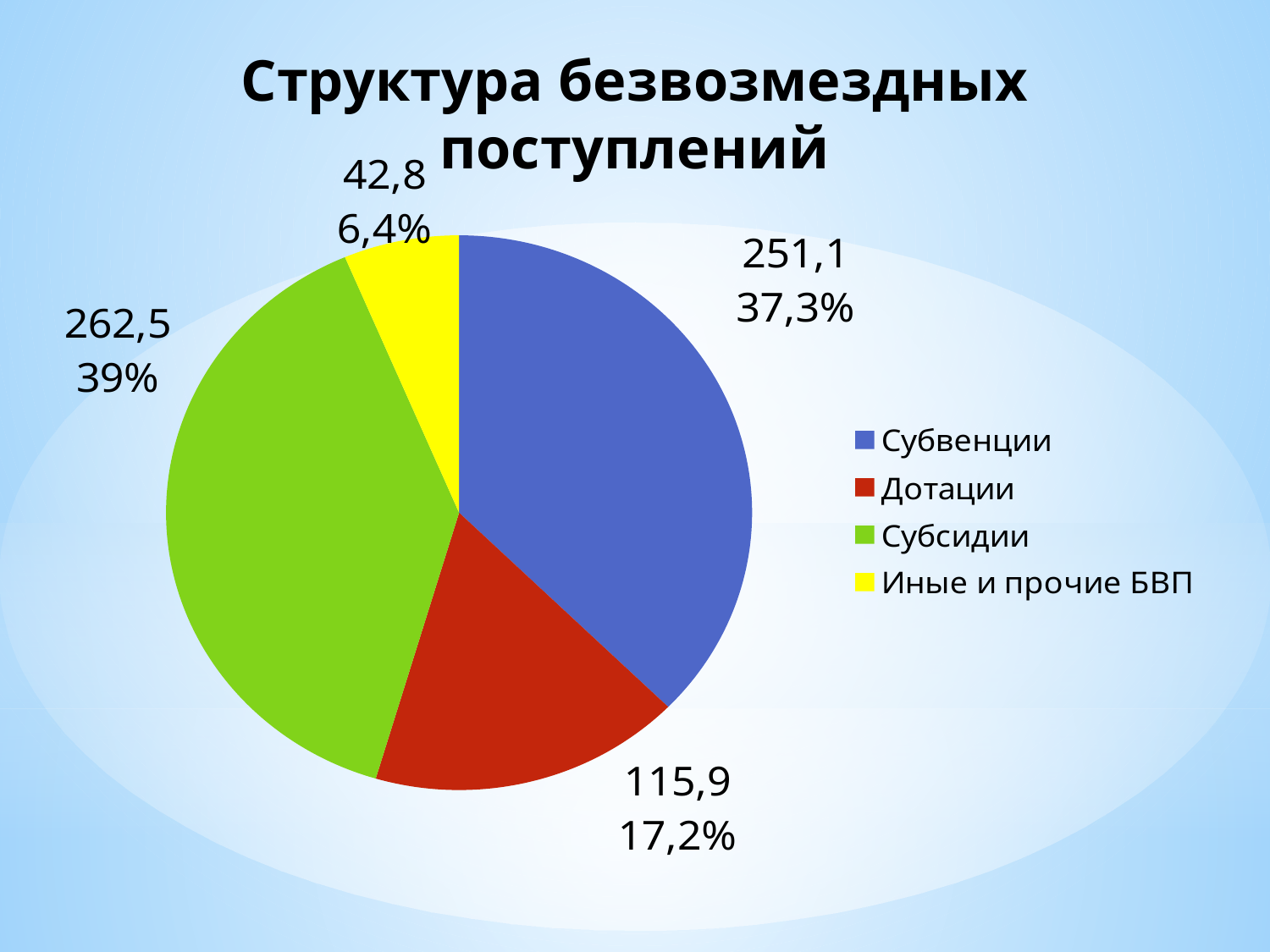
Which is larger, the value for Дотации or the value for Иные и прочие БВП? Дотации What value is shown for Дотации? 115,9 What value is shown for Иные и прочие БВП? 42,8 What share of the pie does Субвенции represent? 37,3% Which category has the smallest slice? Иные и прочие БВП What share of the pie does Иные и прочие БВП represent? 6,4% What is the difference between the values for Субвенции and Дотации? 135,2 Which category has the largest slice? Субсидии What type of chart is shown on the slide? Pie chart What value is shown for Субсидии? 262,5 What value is shown for Субвенции? 251,1 How many categories does the pie chart show? 4